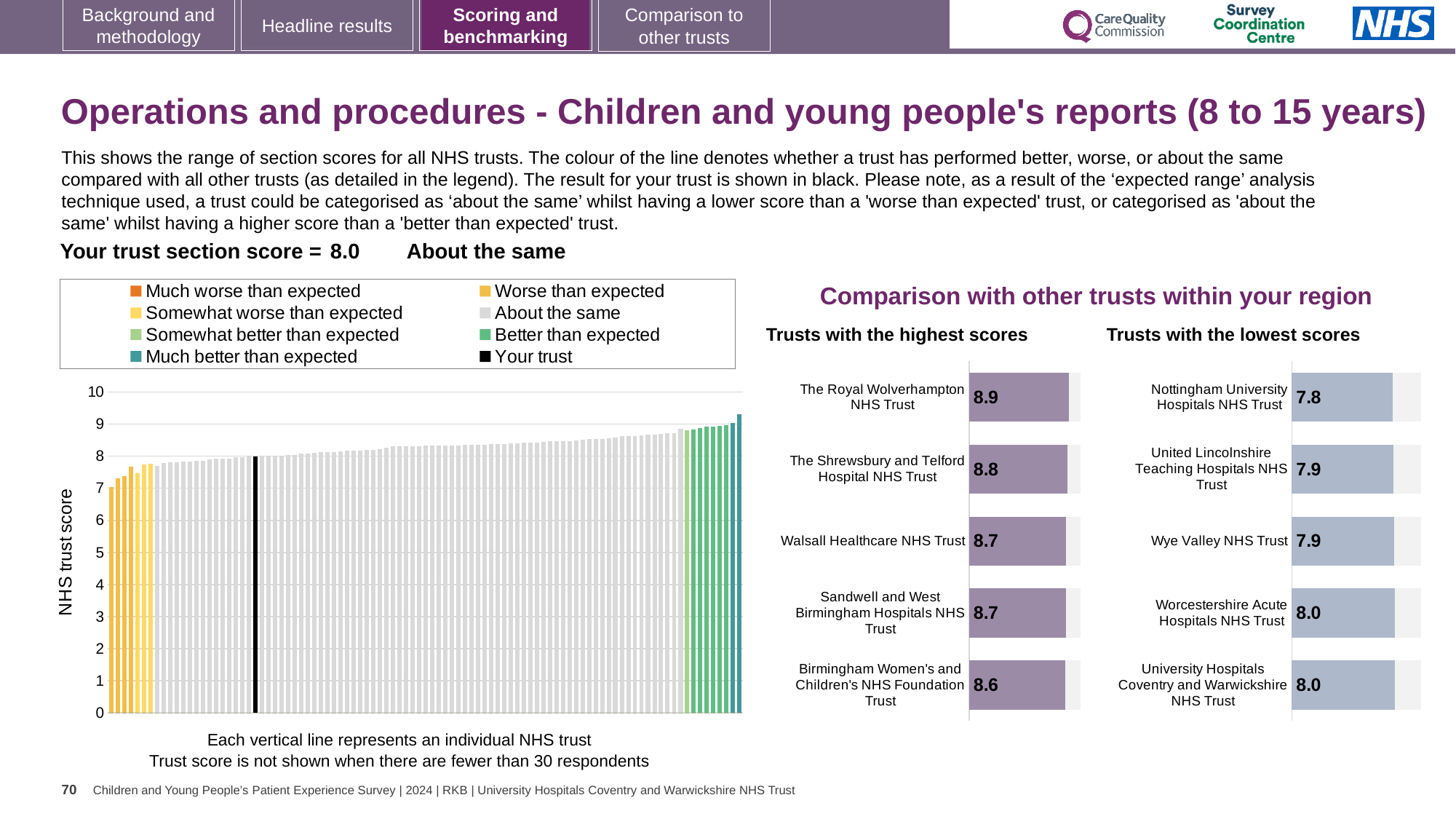
In the 'Trusts with the lowest scores' chart, what is the score for Wye Valley NHS Trust? 7.9 How many trusts are shown in the 'Trusts with the lowest scores' chart? 5 In the 'Trusts with the highest scores' chart, what is the score for Walsall Healthcare NHS Trust? 8.7 Which has a higher score: Walsall Healthcare NHS Trust in the 'Trusts with the highest scores' chart or Wye Valley NHS Trust in the 'Trusts with the lowest scores' chart? Walsall Healthcare NHS Trust What type of chart is the large chart on the left showing NHS trust scores? Bar chart In the 'Trusts with the highest scores' chart, what is the score for The Royal Wolverhampton NHS Trust? 8.9 In the large chart on the left, do the trust scores rise or fall from left to right? Rise In the 'Trusts with the lowest scores' chart, what is the score for Nottingham University Hospitals NHS Trust? 7.8 In the 'Trusts with the highest scores' chart, what is the difference between the scores of The Royal Wolverhampton NHS Trust and Birmingham Women's and Children's NHS Foundation Trust? 0.3 In the 'Trusts with the lowest scores' chart, which trust has the lowest score? Nottingham University Hospitals NHS Trust How many entries does the legend of the large chart on the left list? 8 In the 'Trusts with the highest scores' chart, which trust has the highest score? The Royal Wolverhampton NHS Trust